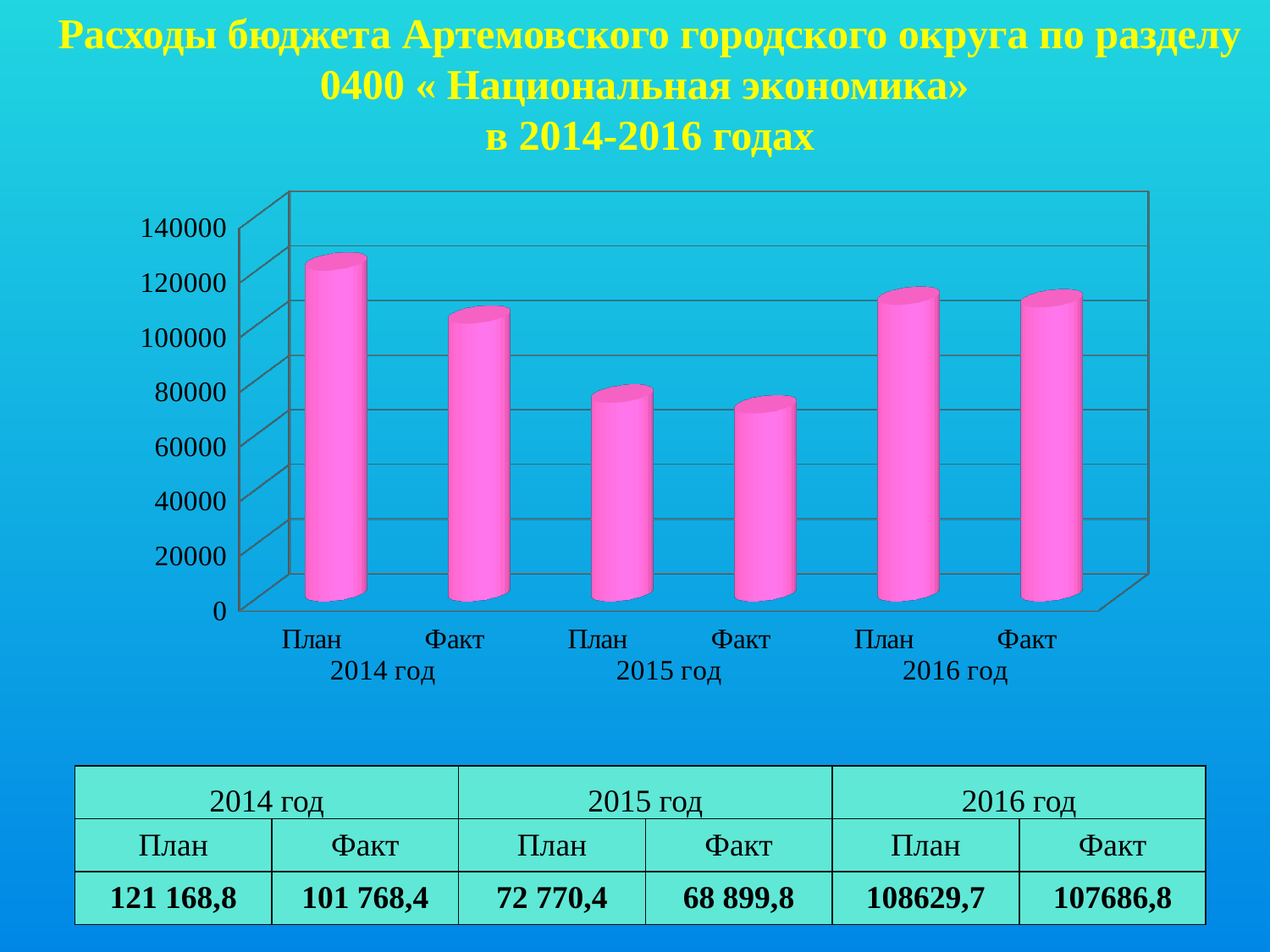
What is the difference between План and Факт in 2014 год? 19 400,4 What is the value for План in 2014 год? 121 168,8 What is the value for Факт in 2015 год? 68 899,8 Which is larger, Факт in 2014 год or Факт in 2016 год? Факт 2016 год Is the value for План in 2016 год greater or less than 100000? greater What is the value for План in 2016 год? 108629,7 Is the value for Факт in 2015 год greater or less than 80000? less What kind of chart is shown on the slide? bar chart Which bar is the lowest in the chart? Факт 2015 год What is the difference between План and Факт in 2015 год? 3 870,6 Which bar is the highest in the chart? План 2014 год How many bars are plotted in the chart? 6